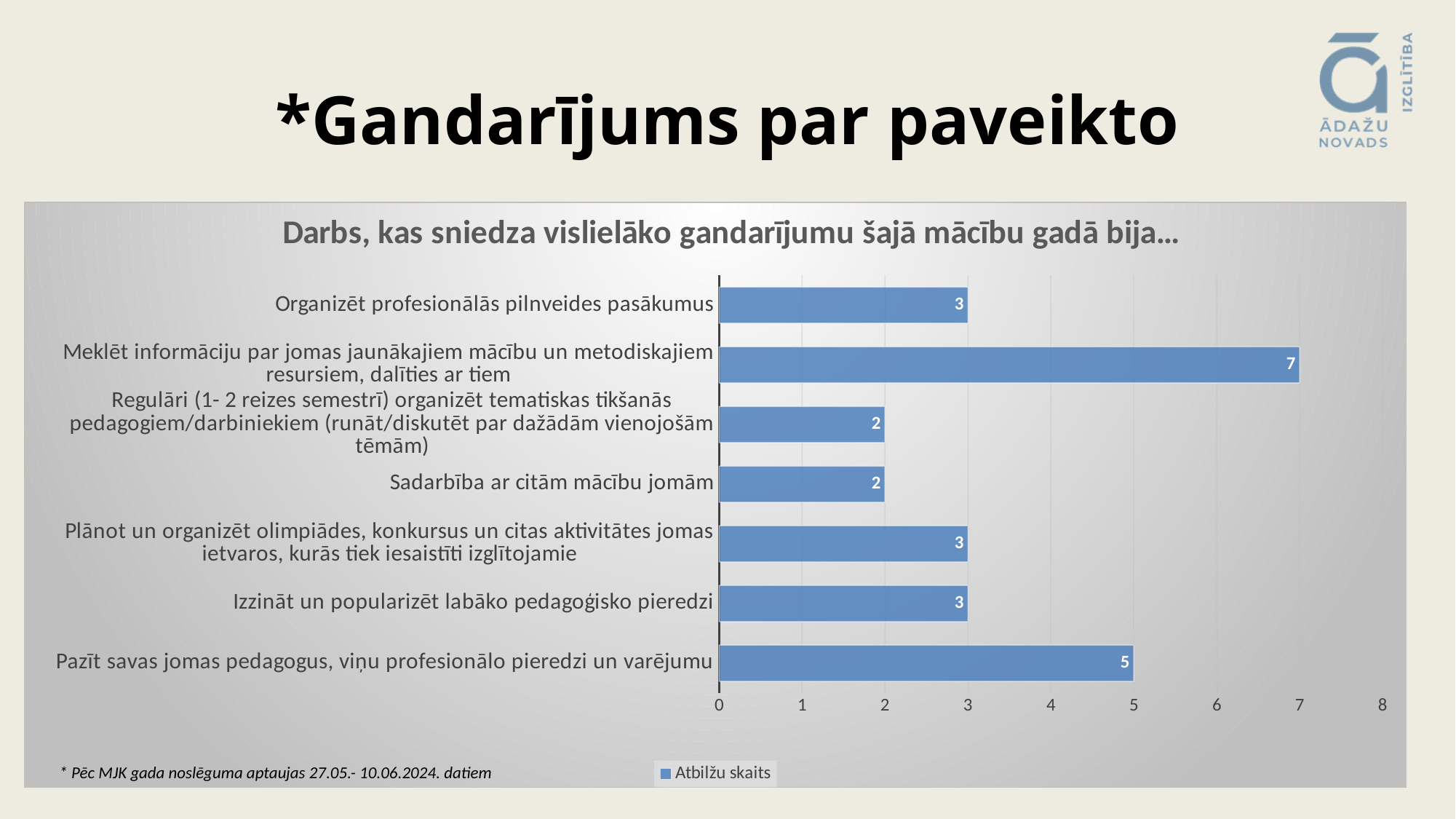
How many categories are shown in the chart? 7 What is the value for "Organizēt profesionālās pilnveides pasākumus"? 3 Which category has the highest value? Meklēt informāciju par jomas jaunākajiem mācību un metodiskajiem resursiem, dalīties ar tiem Is the value for "Meklēt informāciju par jomas jaunākajiem mācību un metodiskajiem resursiem, dalīties ar tiem" greater or less than 6? greater What is the title of the chart? Darbs, kas sniedza vislielāko gandarījumu šajā mācību gadā bija… What is the difference between the value for "Meklēt informāciju par jomas jaunākajiem mācību un metodiskajiem resursiem, dalīties ar tiem" and the value for "Pazīt savas jomas pedagogus, viņu profesionālo pieredzi un varējumu"? 2 What is the value for "Pazīt savas jomas pedagogus, viņu profesionālo pieredzi un varējumu"? 5 Which is larger: the value for "Izzināt un popularizēt labāko pedagoģisko pieredzi" or the value for "Sadarbība ar citām mācību jomām"? Izzināt un popularizēt labāko pedagoģisko pieredzi What kind of chart is shown on the slide? bar chart What is the legend entry of the chart? Atbilžu skaits How many series does the legend list? 1 What is the value for "Sadarbība ar citām mācību jomām"? 2